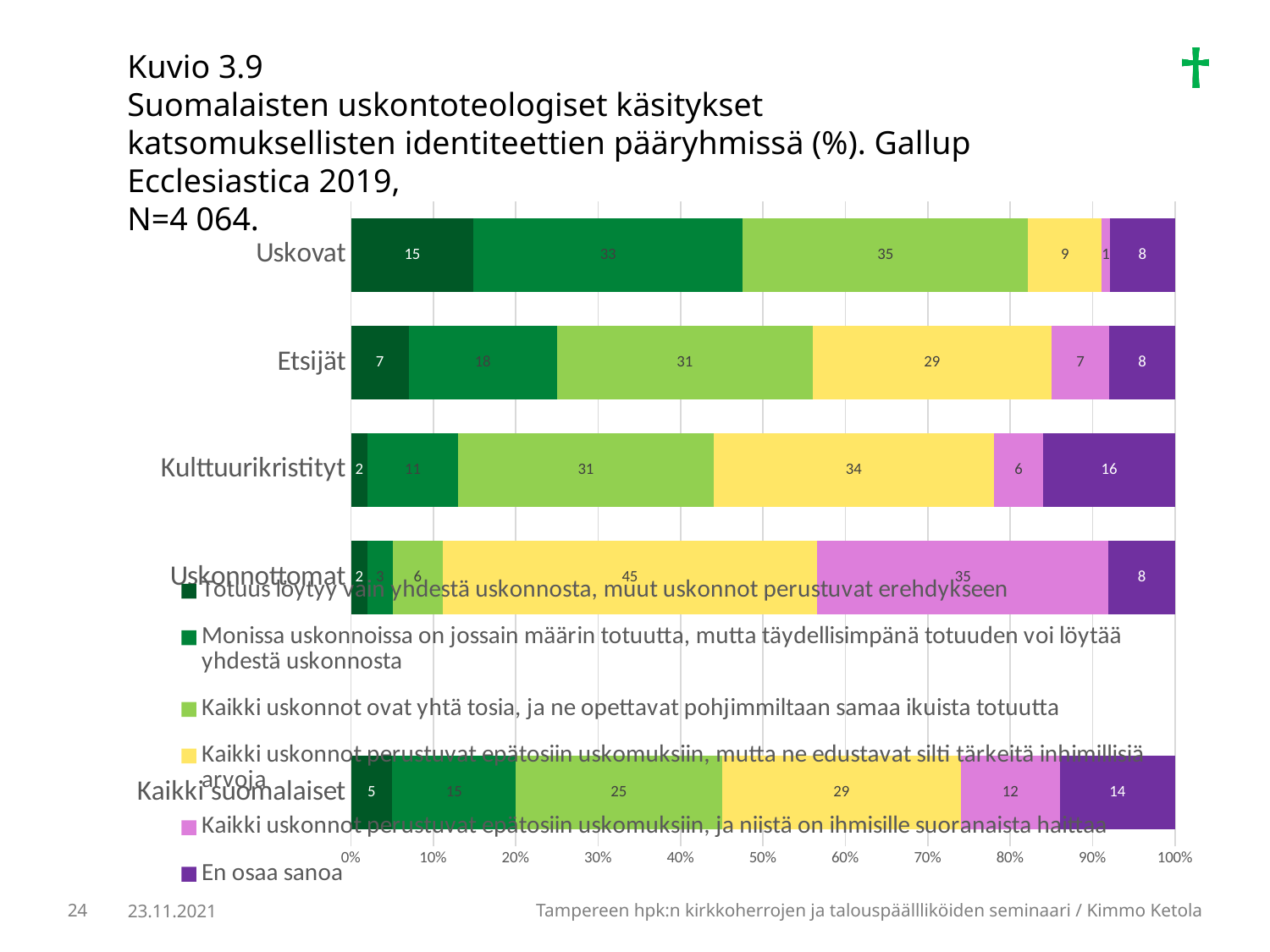
Which is larger: the 'En osaa sanoa' value for Kulttuurikristityt or for Etsijät? Kulttuurikristityt How many categories (groups) are shown on the vertical axis of the chart? 5 Which category has the highest value for the 'Totuus löytyy vain yhdestä uskonnosta, muut uskonnot perustuvat erehdykseen' segment? Uskovat What is the difference between the 'Kaikki uskonnot perustuvat epätosiin uskomuksiin, mutta ne edustavat silti tärkeitä inhimillisiä arvoja' values for Uskonnottomat and Uskovat? 36 What is the value of the 'En osaa sanoa' segment for Kulttuurikristityt? 16 What is the value of the 'Totuus löytyy vain yhdestä uskonnosta, muut uskonnot perustuvat erehdykseen' segment for Kaikki suomalaiset? 5 How many series does the legend list? 6 What is the value of the 'Kaikki uskonnot perustuvat epätosiin uskomuksiin, ja niistä on ihmisille suoranaista haittaa' segment for Uskonnottomat? 35 What is the value of the 'Kaikki uskonnot ovat yhtä tosia, ja ne opettavat pohjimmiltaan samaa ikuista totuutta' segment for Uskovat? 35 What kind of chart is shown on the slide? Stacked bar chart What is the total of the stacked bar for Etsijät? 100 Which category has the lowest value for the 'Kaikki uskonnot ovat yhtä tosia, ja ne opettavat pohjimmiltaan samaa ikuista totuutta' segment? Uskonnottomat